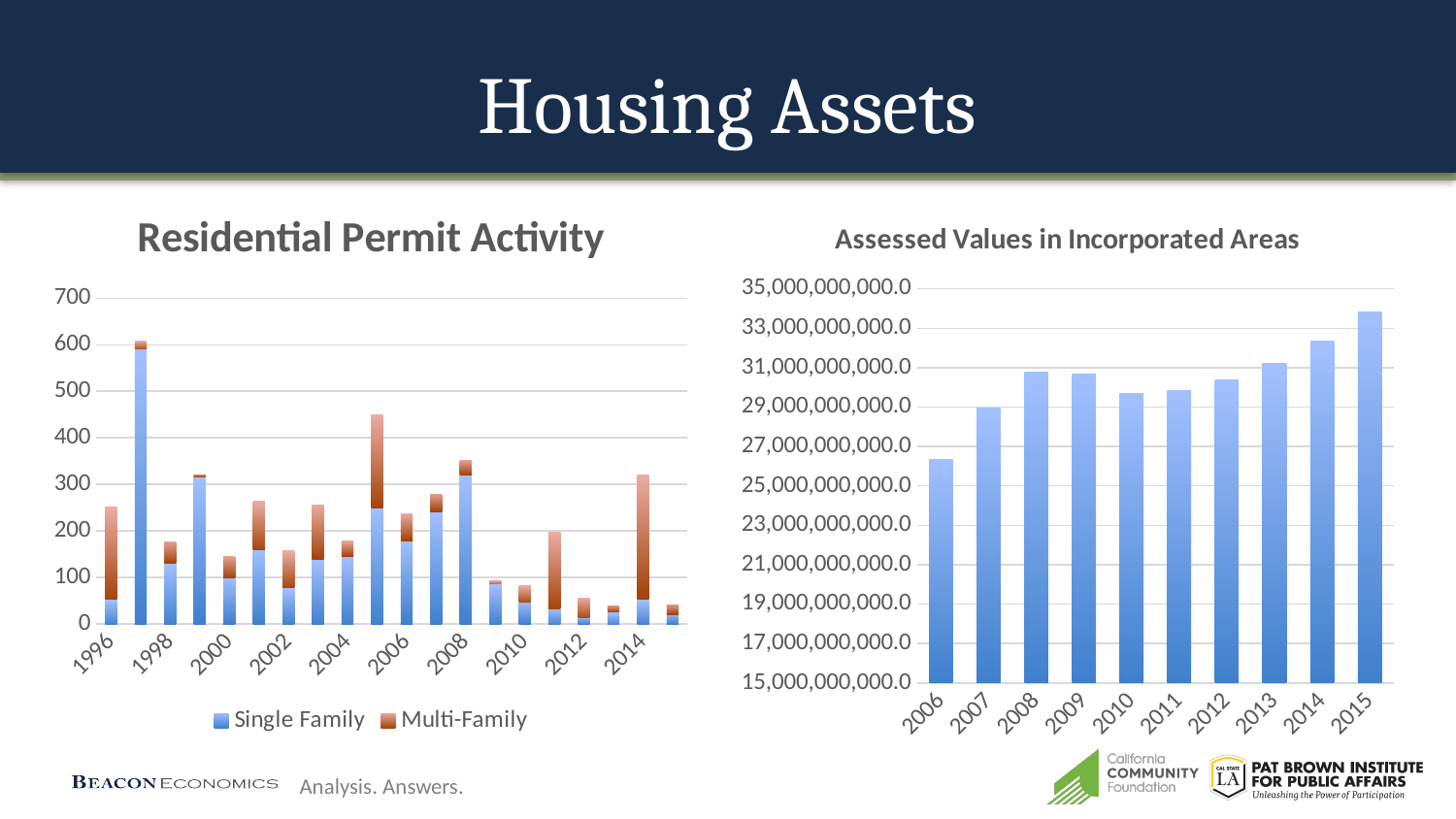
In the 'Residential Permit Activity' chart, is the Single Family value for 1997 greater or less than 500? greater In the 'Assessed Values in Incorporated Areas' chart, which year has the highest value? 2015 In the 'Assessed Values in Incorporated Areas' chart, which is larger, the value for 2008 or the value for 2010? 2008 In the 'Residential Permit Activity' chart, which year has the tallest stacked bar? 1997 In the 'Assessed Values in Incorporated Areas' chart, is the value for 2006 greater or less than 27,000,000,000.0? less How many series does the legend of the 'Residential Permit Activity' chart list? 2 What are the two legend entries in the 'Residential Permit Activity' chart? Single Family and Multi-Family How many years are plotted in the 'Assessed Values in Incorporated Areas' chart? 10 In the 'Assessed Values in Incorporated Areas' chart, which year has the lowest value? 2006 In the 'Residential Permit Activity' chart, is the total for 2015 greater or less than 100? less What kind of chart is the 'Residential Permit Activity' chart? Stacked bar chart